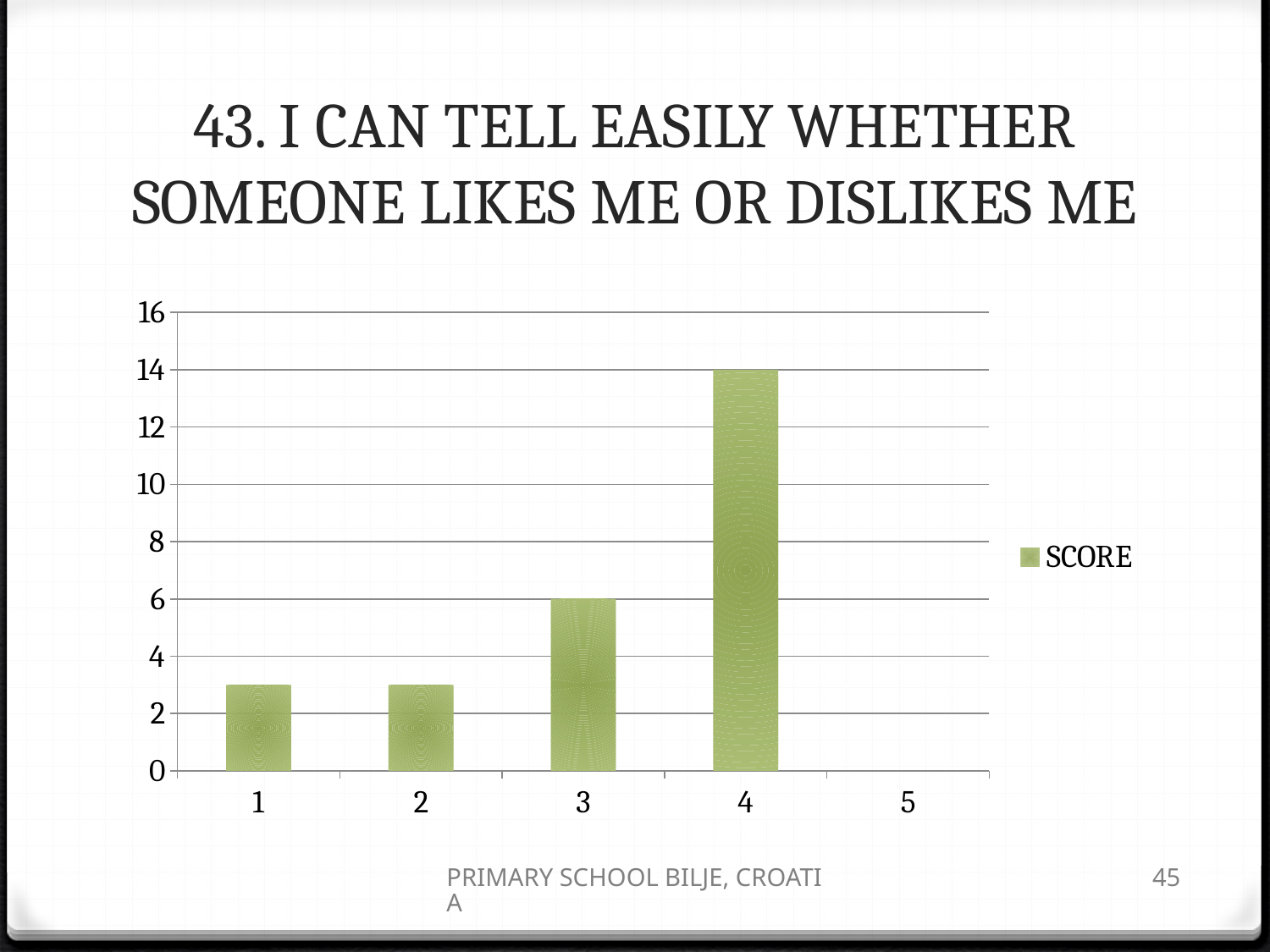
Is the value for category 1 greater or less than 4? less What is the value for category 5? 0 What is the difference between the values for category 4 and category 3? 8 What is the value for category 3? 6 What kind of chart is shown on the slide? bar chart How many categories are shown on the x axis? 5 How many series does the legend list? 1 Which is larger, the value for category 3 or the value for category 4? 4 Which category has the lowest value? 5 What is the value for category 4? 14 Which category has the highest value? 4 Is the value for category 2 greater or less than 2? greater